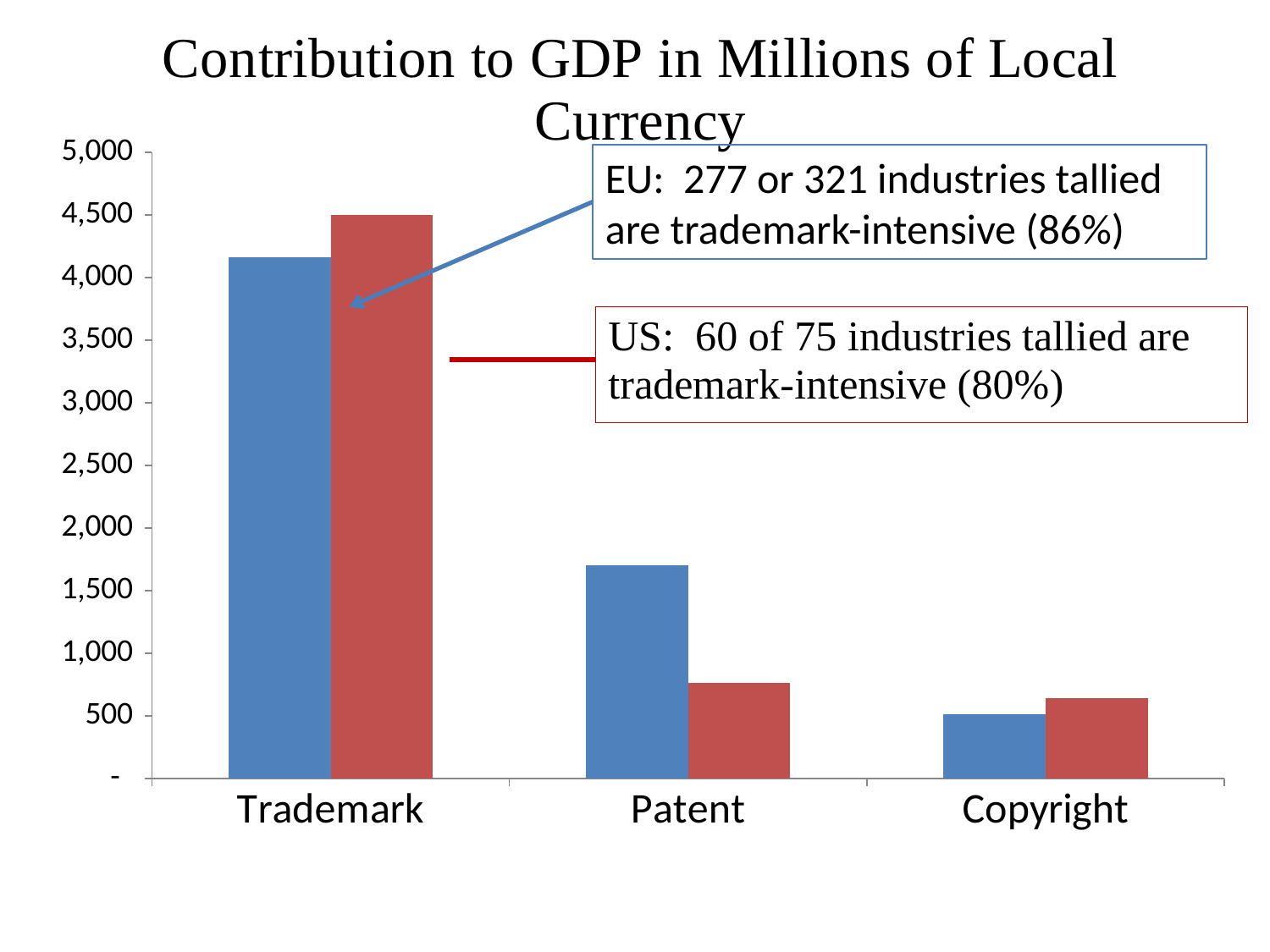
How many categories are shown on the x axis? 3 What is the title of the chart? Contribution to GDP in Millions of Local Currency What kind of chart is shown on the slide? bar chart Which category has the tallest blue bar? Trademark Is the value of the blue bar for Trademark greater or less than 4,000? greater Do the blue bars rise or fall moving from Trademark to Copyright along the x axis? fall For Trademark, which bar is taller, the blue one or the red one? red Is the value of the red bar for Patent greater or less than 1,000? less For Patent, which bar is taller, the blue one or the red one? blue Which category has the shortest blue bar? Copyright Which category has the shortest red bar? Copyright Is the value of the blue bar for Patent greater or less than 1,500? greater